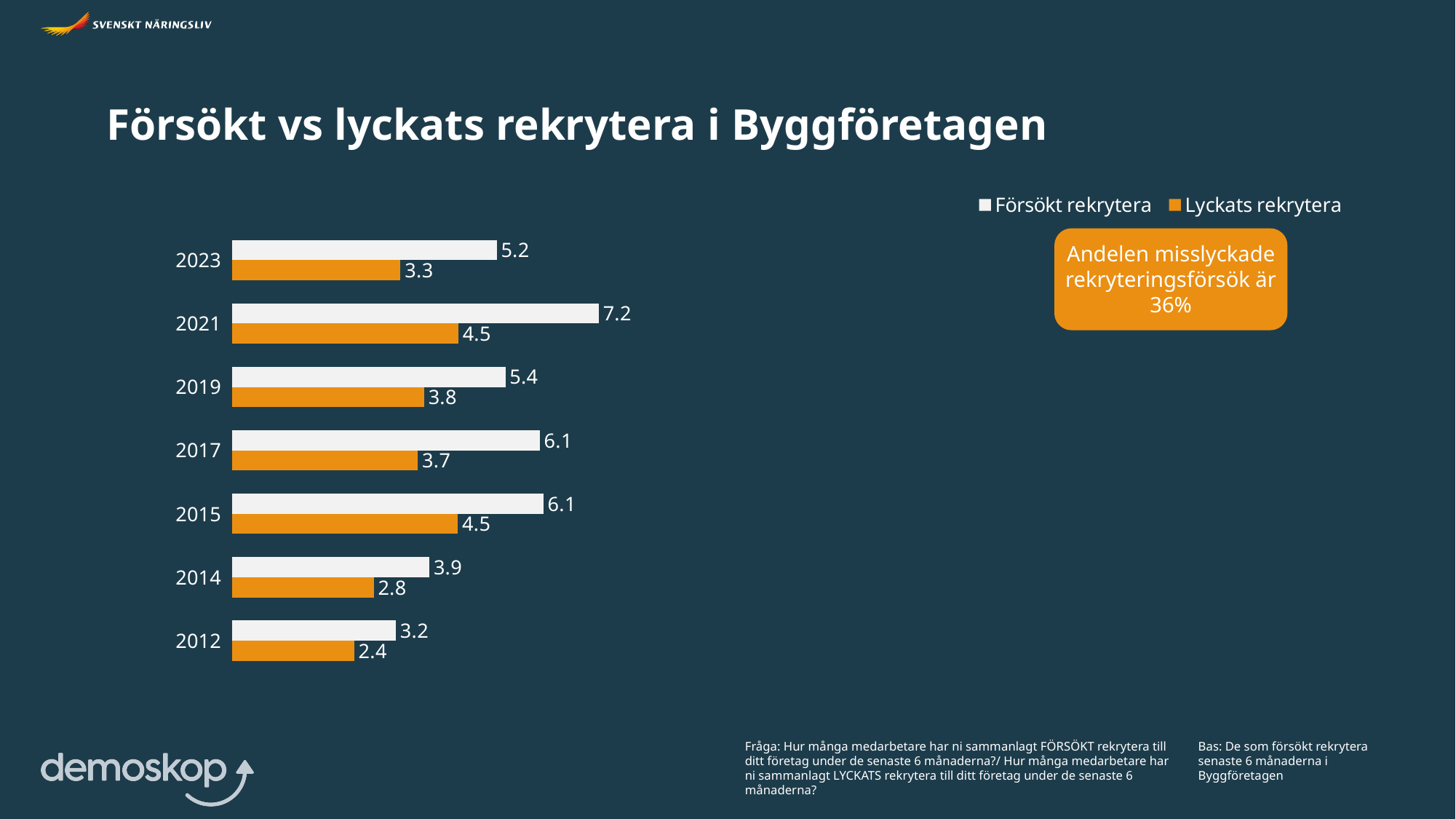
Which year has the lowest value for Lyckats rekrytera? 2012 What is the value for Lyckats rekrytera in 2023? 3.3 What colour are the Lyckats rekrytera bars? Orange What is the value for Försökt rekrytera in 2021? 7.2 What is the difference between Försökt rekrytera in 2023 and in 2014? 1.3 What is the difference between Försökt rekrytera and Lyckats rekrytera in 2021? 2.7 Which year has the highest value for Försökt rekrytera? 2021 What kind of chart is shown on the slide? Bar chart What is the value for Lyckats rekrytera in 2012? 2.4 How many years are shown on the chart? 7 Which is larger: Lyckats rekrytera in 2019 or Lyckats rekrytera in 2017? 2019 How many series does the legend list? 2